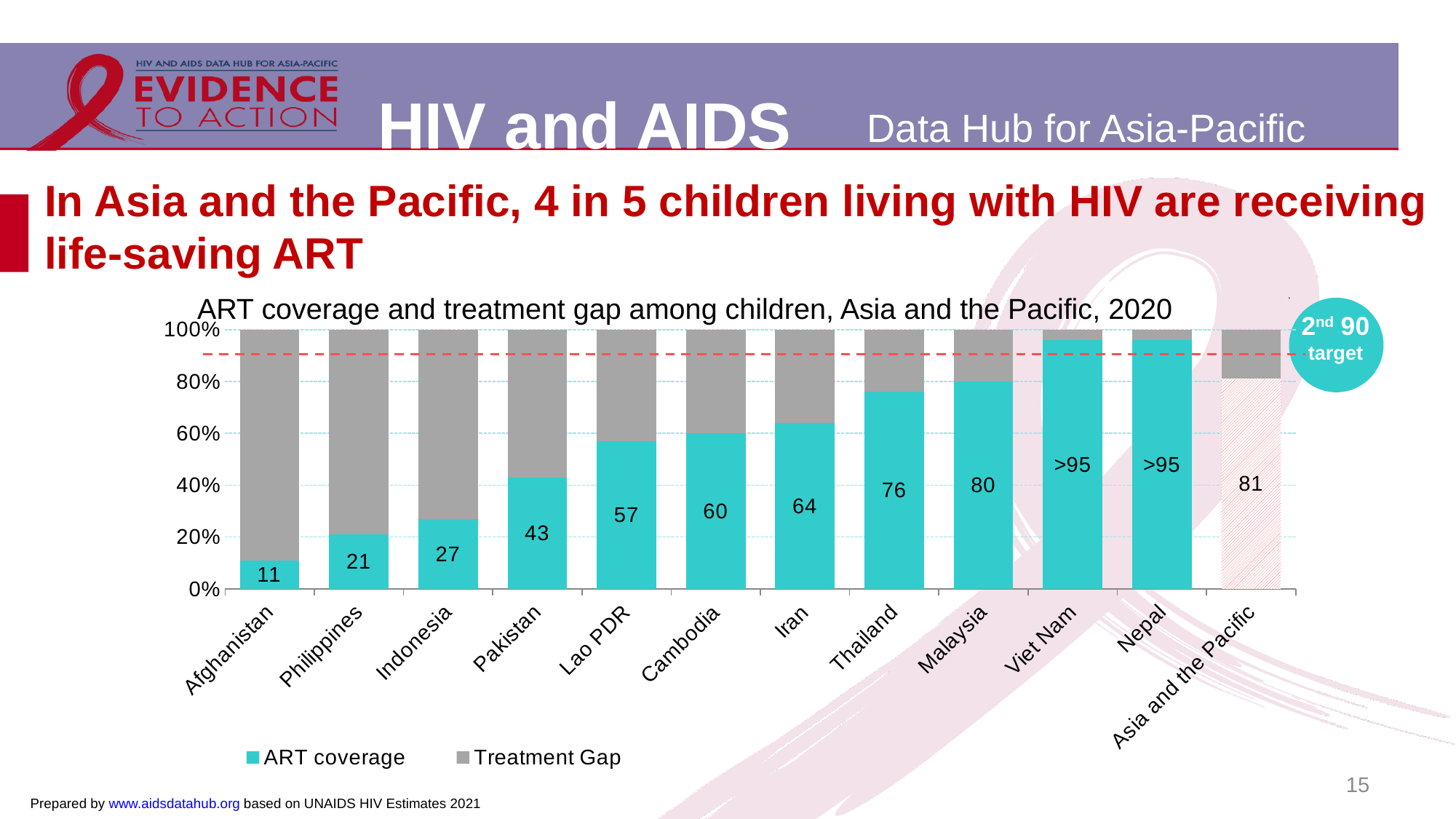
What is the ART coverage value shown for Viet Nam? >95 What is the ART coverage value shown for Afghanistan? 11 How many series does the chart legend list? 2 What is the ART coverage value shown for Thailand? 76 What is the ART coverage value shown for Asia and the Pacific? 81 Which has a higher ART coverage value, Cambodia or Pakistan? Cambodia How many categories are shown on the x axis of the chart? 12 What is the difference between the ART coverage values for Malaysia and Thailand? 4 Which country has the lowest ART coverage in the chart? Afghanistan Do the ART coverage values rise or fall from Afghanistan to Nepal along the x axis? rise What kind of chart is shown on the slide? stacked bar chart Is the ART coverage for Indonesia greater or less than 40%? less